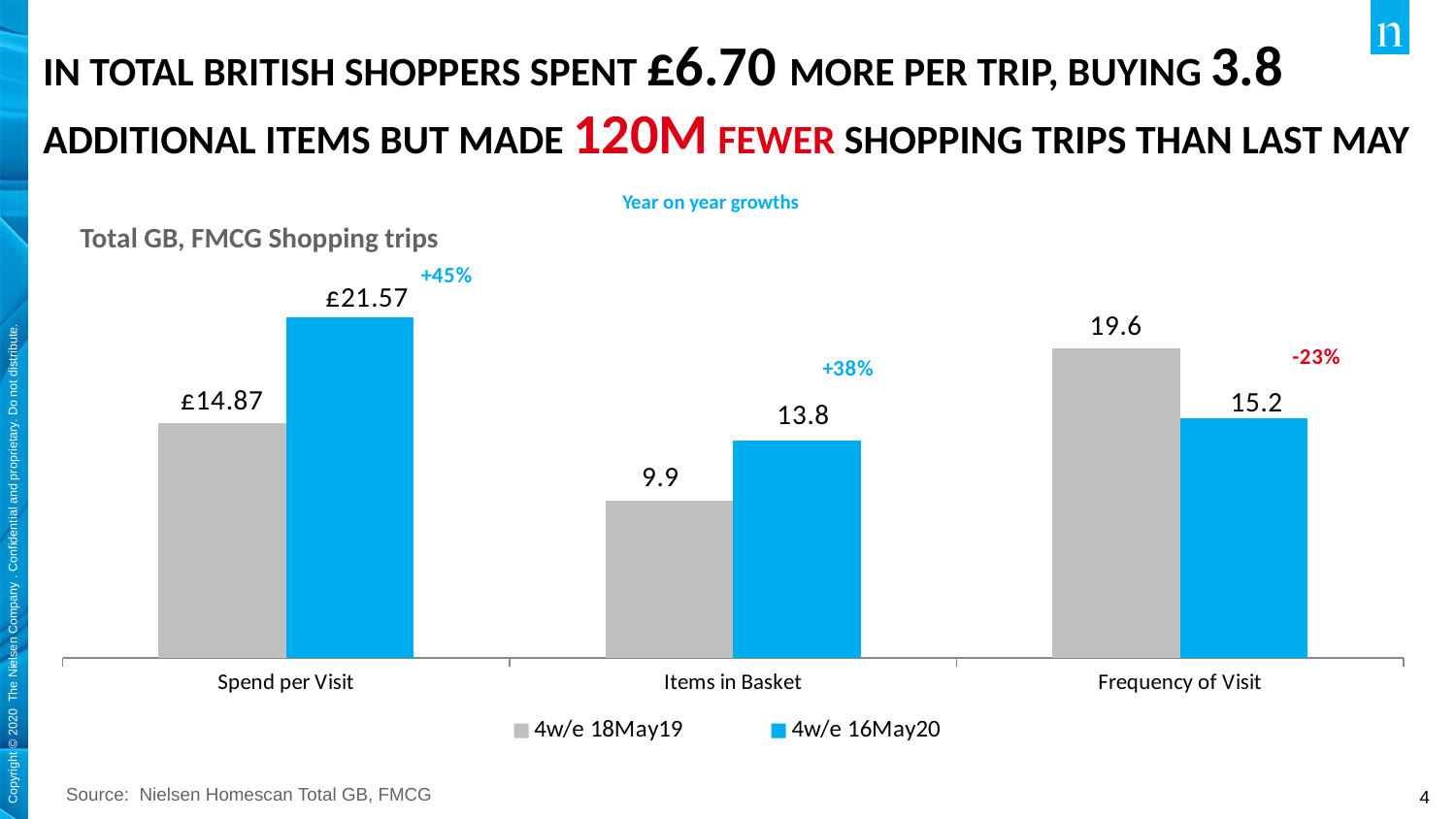
What is the year on year growth shown for Items in Basket? +38% What is the value for Spend per Visit in the 4w/e 16May20 series? £21.57 For Frequency of Visit, which series has the larger value, 4w/e 18May19 or 4w/e 16May20? 4w/e 18May19 What is the value for Frequency of Visit in the 4w/e 16May20 series? 15.2 What is the value for Items in Basket in the 4w/e 18May19 series? 9.9 What is the difference between the 4w/e 18May19 and 4w/e 16May20 values for Frequency of Visit? 4.4 What kind of chart is shown on the slide? Bar chart How many series does the chart legend list? 2 How many categories are shown on the x axis of the chart? 3 For Items in Basket, which series has the larger value, 4w/e 18May19 or 4w/e 16May20? 4w/e 16May20 What is the difference between the 4w/e 16May20 and 4w/e 18May19 values for Spend per Visit? £6.70 What is the year on year growth shown for Frequency of Visit? -23%